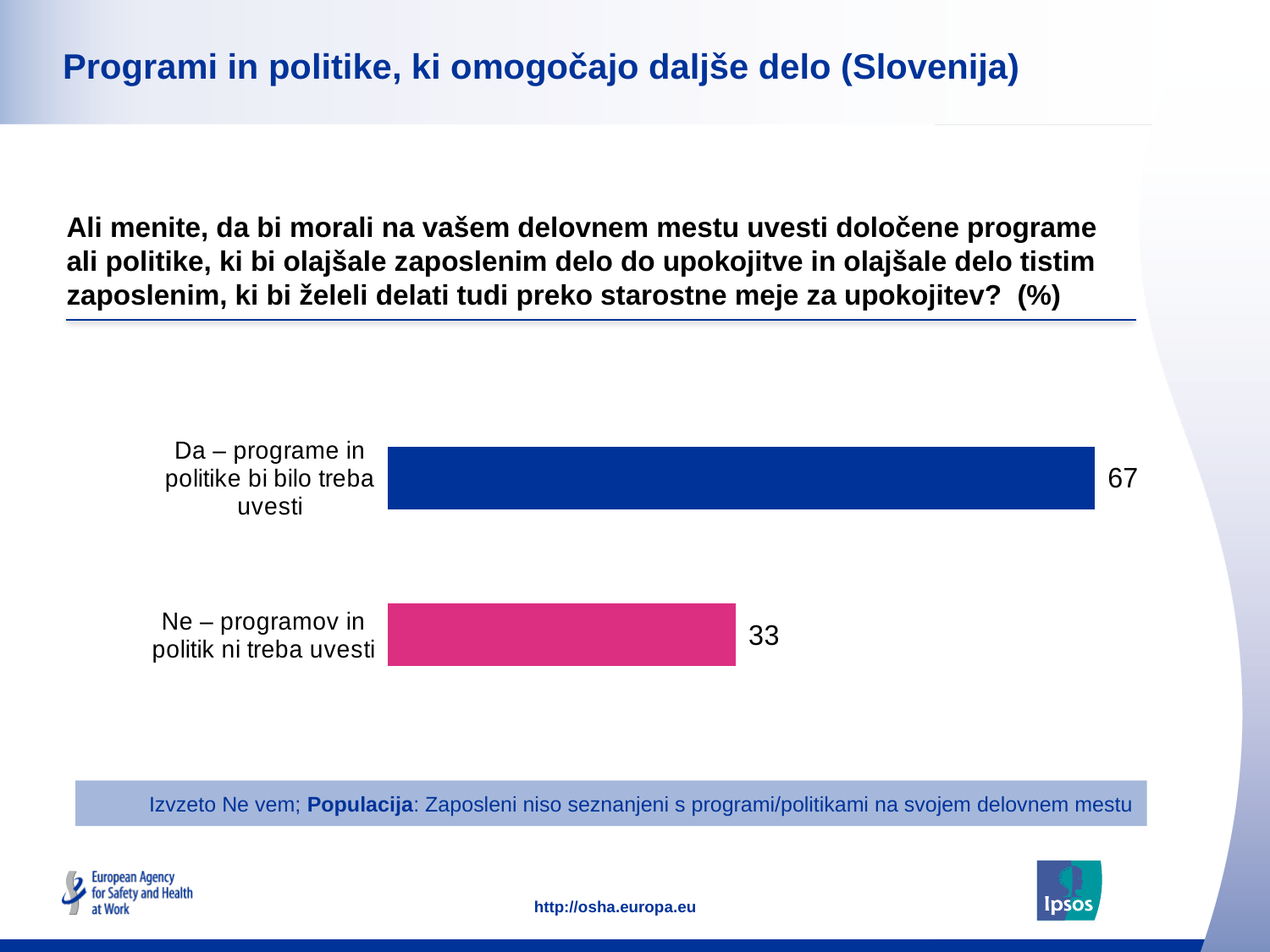
What is the total of the two values shown in the chart? 100 What is the difference between the values for "Da – programe in politike bi bilo treba uvesti" and "Ne – programov in politik ni treba uvesti"? 34 How many categories are shown in the chart? 2 What kind of chart is shown on the slide? Bar chart What colour is the bar for "Ne – programov in politik ni treba uvesti"? Pink What colour is the bar for "Da – programe in politike bi bilo treba uvesti"? Blue Which category has the highest value? Da – programe in politike bi bilo treba uvesti Which category has the lowest value? Ne – programov in politik ni treba uvesti Which is larger: the value for "Da – programe in politike bi bilo treba uvesti" or for "Ne – programov in politik ni treba uvesti"? Da – programe in politike bi bilo treba uvesti What is the value for "Da – programe in politike bi bilo treba uvesti"? 67 What is the value for "Ne – programov in politik ni treba uvesti"? 33